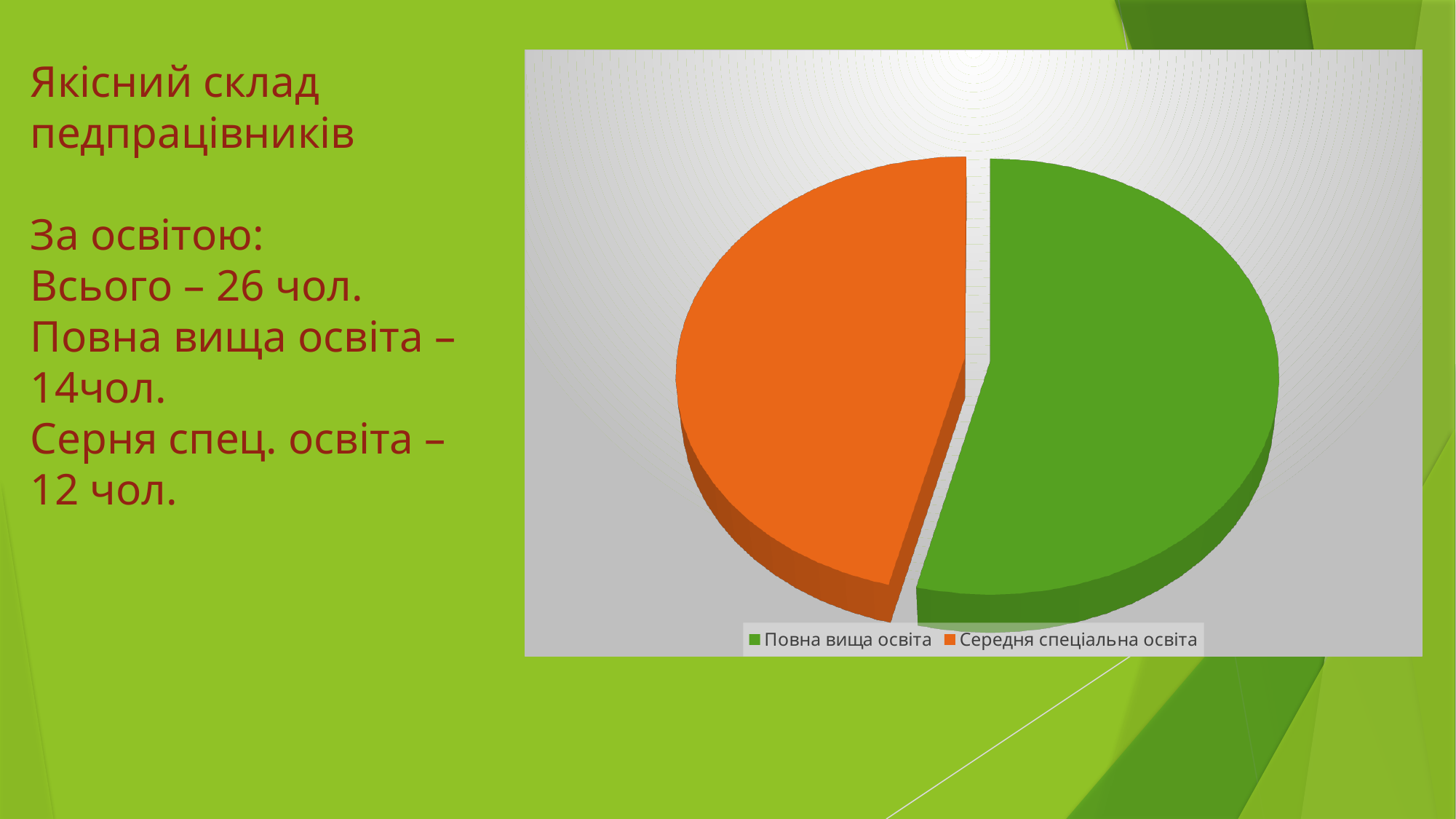
How many slices does the pie chart have? 2 What colour is the slice for Повна вища освіта in the pie chart? green What colour is the slice for Середня спеціальна освіта in the pie chart? orange What kind of chart is shown on the slide? pie chart According to the slide, how many teachers have Повна вища освіта? 14 According to the slide, how many teachers have Середня спеціальна освіта? 12 Which is larger in the pie chart: Повна вища освіта or Середня спеціальна освіта? Повна вища освіта What is the difference between the number of teachers with Повна вища освіта and those with Середня спеціальна освіта? 2 Which slice of the pie chart is the smallest? Середня спеціальна освіта Which slice of the pie chart is the largest? Повна вища освіта How many entries does the legend of the pie chart list? 2 According to the slide, what is the total number of teachers represented in the pie chart? 26